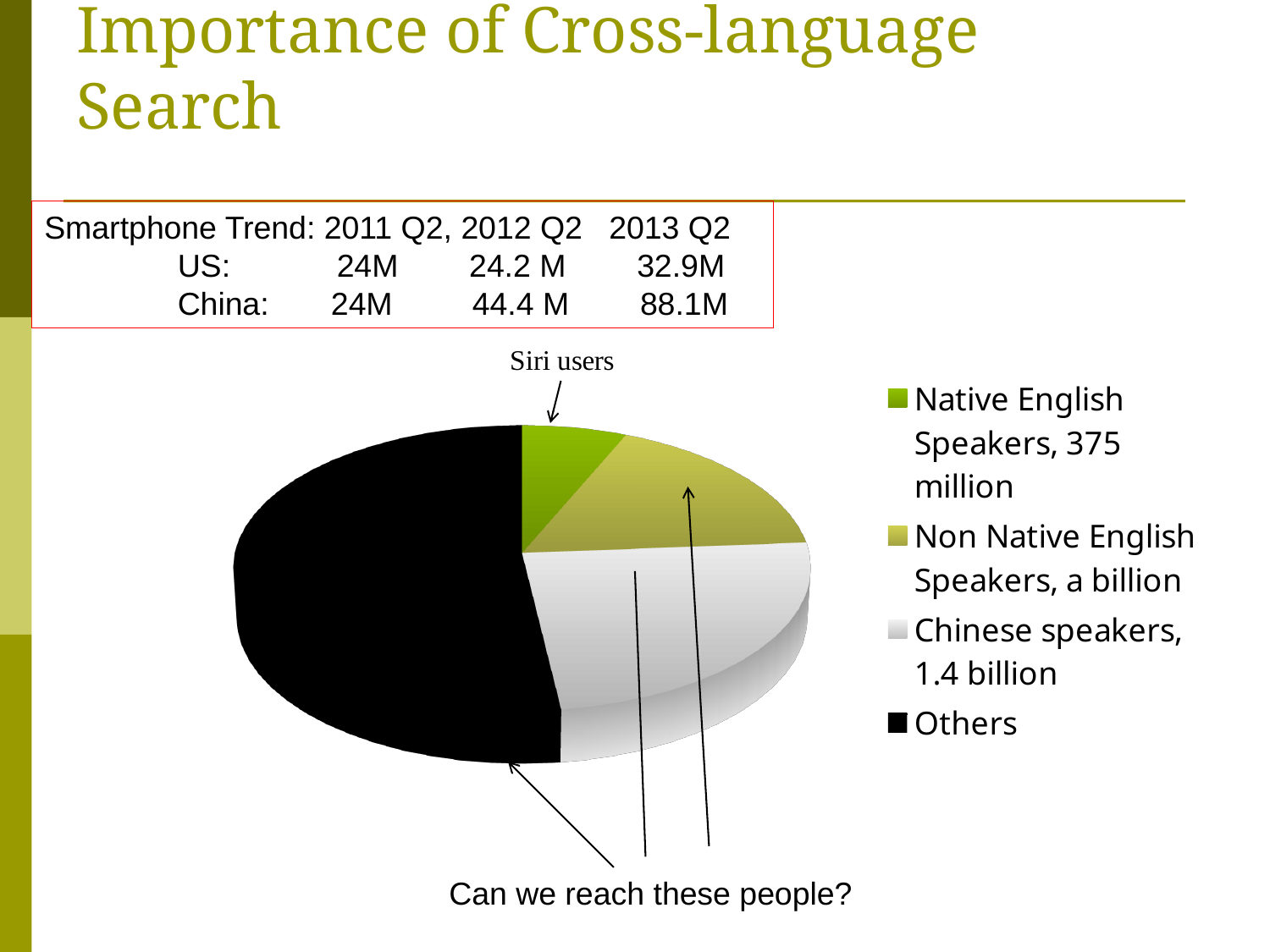
What colour is the Others slice in the pie chart? black According to the legend, how many Chinese speakers are there? 1.4 billion According to the legend, how many Native English Speakers are there? 375 million Which group is larger, Native English Speakers or Chinese speakers? Chinese speakers Which slice of the pie chart is the largest? Others How many slices does the pie chart have? 4 How many entries does the pie chart's legend list? 4 What kind of chart is shown on the slide? pie chart Which slice of the pie chart does the 'Siri users' annotation point to? Native English Speakers Which slice of the pie chart is the smallest? Native English Speakers Which group is larger, Chinese speakers or Non Native English Speakers? Chinese speakers According to the legend, how many Non Native English Speakers are there? a billion